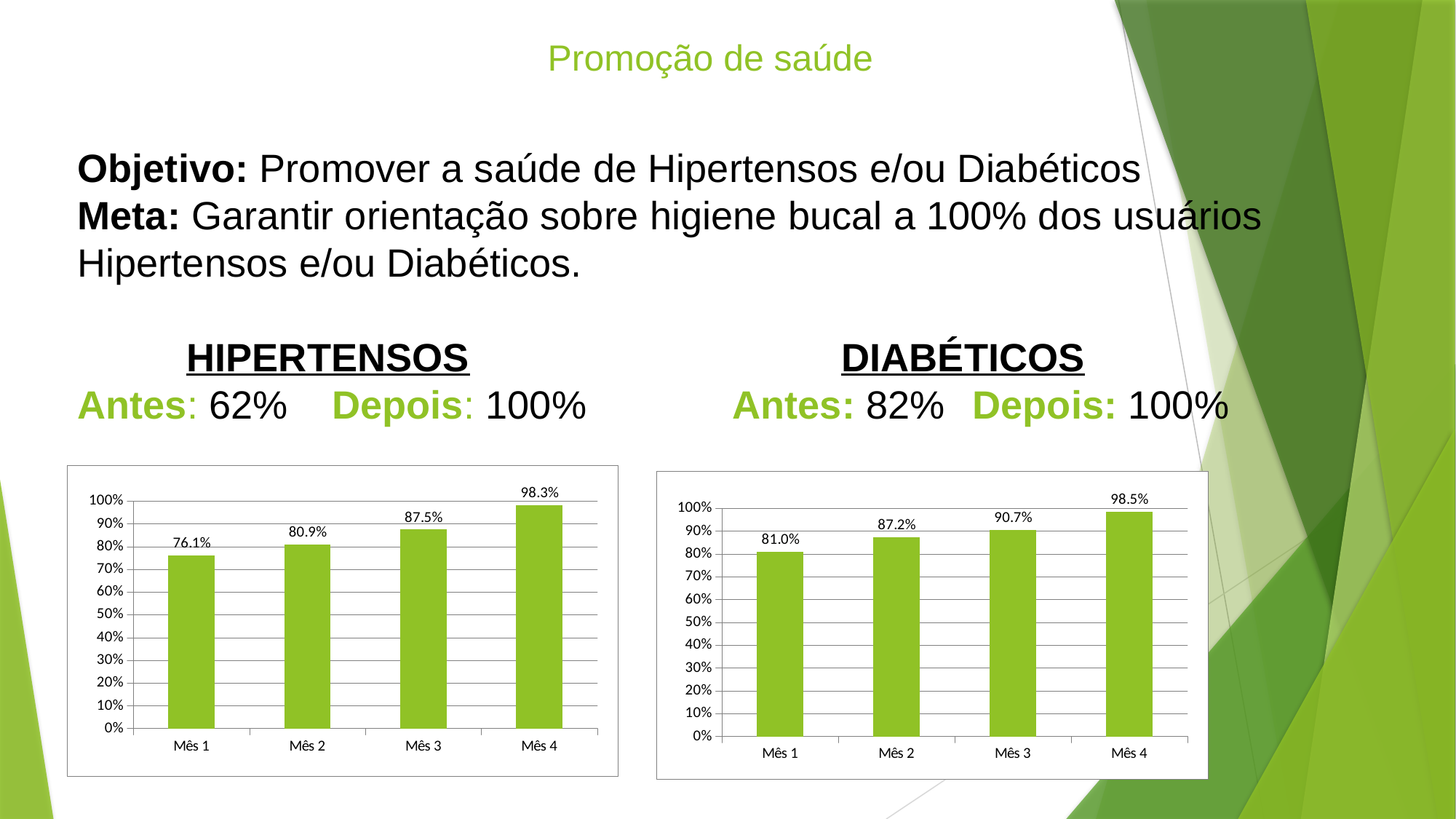
What kind of chart is the DIABÉTICOS chart (right)? bar chart In the HIPERTENSOS chart (left), which is larger, the value for Mês 2 or Mês 3? Mês 3 In the DIABÉTICOS chart (right), what is the value for Mês 3? 90.7% In the DIABÉTICOS chart (right), is the value for Mês 1 greater or less than 90%? less In the DIABÉTICOS chart (right), what is the difference between the values for Mês 2 and Mês 1? 6.2% In the HIPERTENSOS chart (left), which month has the highest value? Mês 4 In the HIPERTENSOS chart (left), what is the difference between the values for Mês 4 and Mês 1? 22.2% In the HIPERTENSOS chart (left), what is the value for Mês 1? 76.1% In the DIABÉTICOS chart (right), which month has the lowest value? Mês 1 In the HIPERTENSOS chart (left), do the values rise or fall from Mês 1 to Mês 4? rise How many months are shown on the x axis of the HIPERTENSOS chart (left)? 4 What colour are the bars in the DIABÉTICOS chart (right)? green